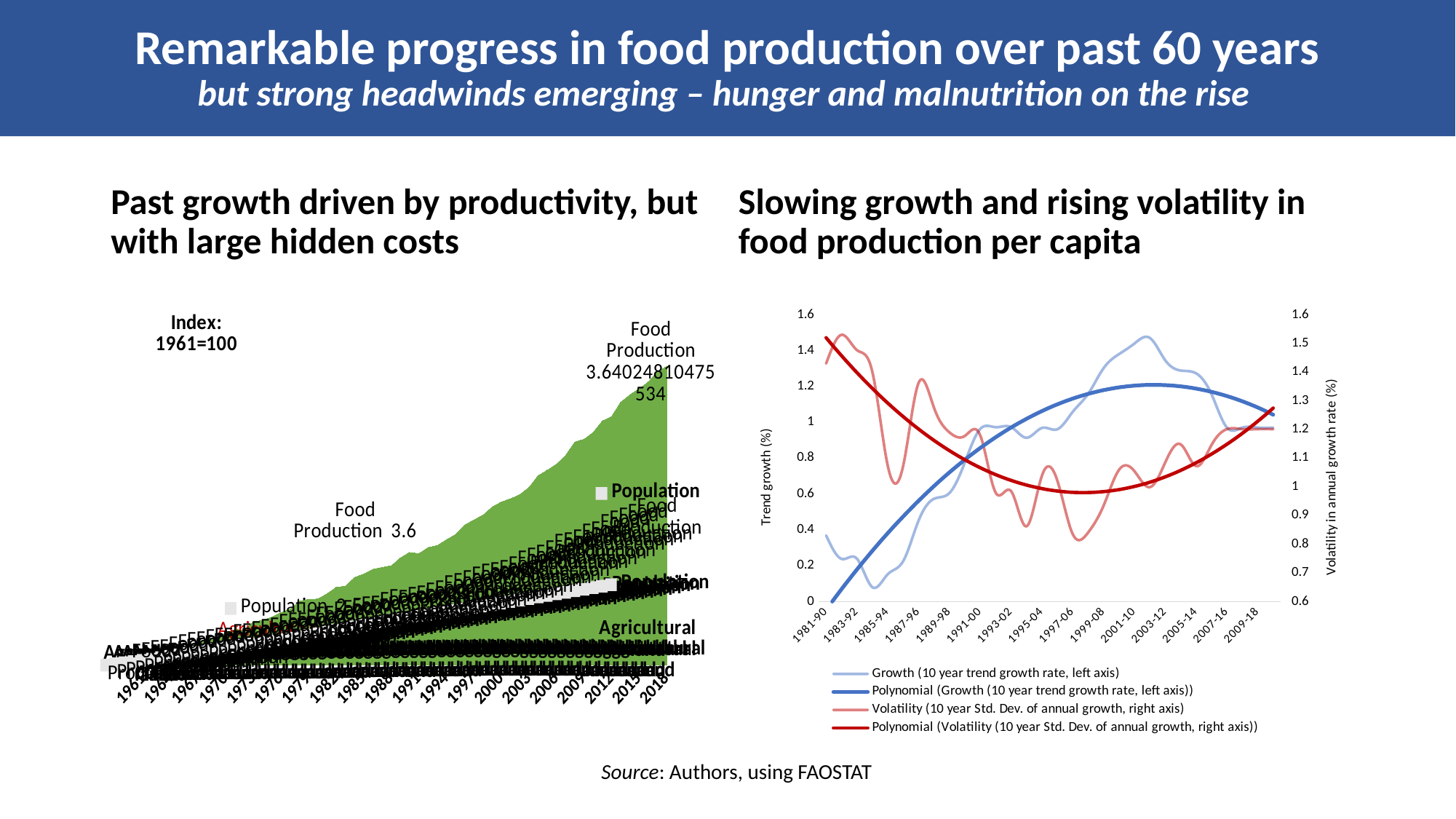
On the right chart (Slowing growth and rising volatility in food production per capita), what is the label of the left vertical axis? Trend growth (%) On the right chart (Slowing growth and rising volatility in food production per capita), does the Polynomial (Volatility) curve fall or rise between 1981-90 and 1997-06? fall On the right chart (Slowing growth and rising volatility in food production per capita), is the Growth (10 year trend growth rate) value for 2003-12 greater or less than 1.2? greater On the right chart (Slowing growth and rising volatility in food production per capita), how many series does the legend list? 4 On the right chart (Slowing growth and rising volatility in food production per capita), is the Volatility value for 1981-90 greater or less than 1.2 on the right axis? greater On the left chart (Past growth driven by productivity, but with large hidden costs), what base year and value does the index note give? 1961=100 On the right chart (Slowing growth and rising volatility in food production per capita), does the Polynomial (Growth) curve rise or fall between 1981-90 and 2001-10? rise On the right chart (Slowing growth and rising volatility in food production per capita), how many period labels are shown on the x axis? 15 On the right chart (Slowing growth and rising volatility in food production per capita), what is the first period label on the x axis? 1981-90 On the right chart (Slowing growth and rising volatility in food production per capita), what is the last period label on the x axis? 2009-18 On the right chart (Slowing growth and rising volatility in food production per capita), what kind of chart is it? line chart On the right chart (Slowing growth and rising volatility in food production per capita), is the Growth (10 year trend growth rate) value for 1981-90 greater or less than 0.6? less